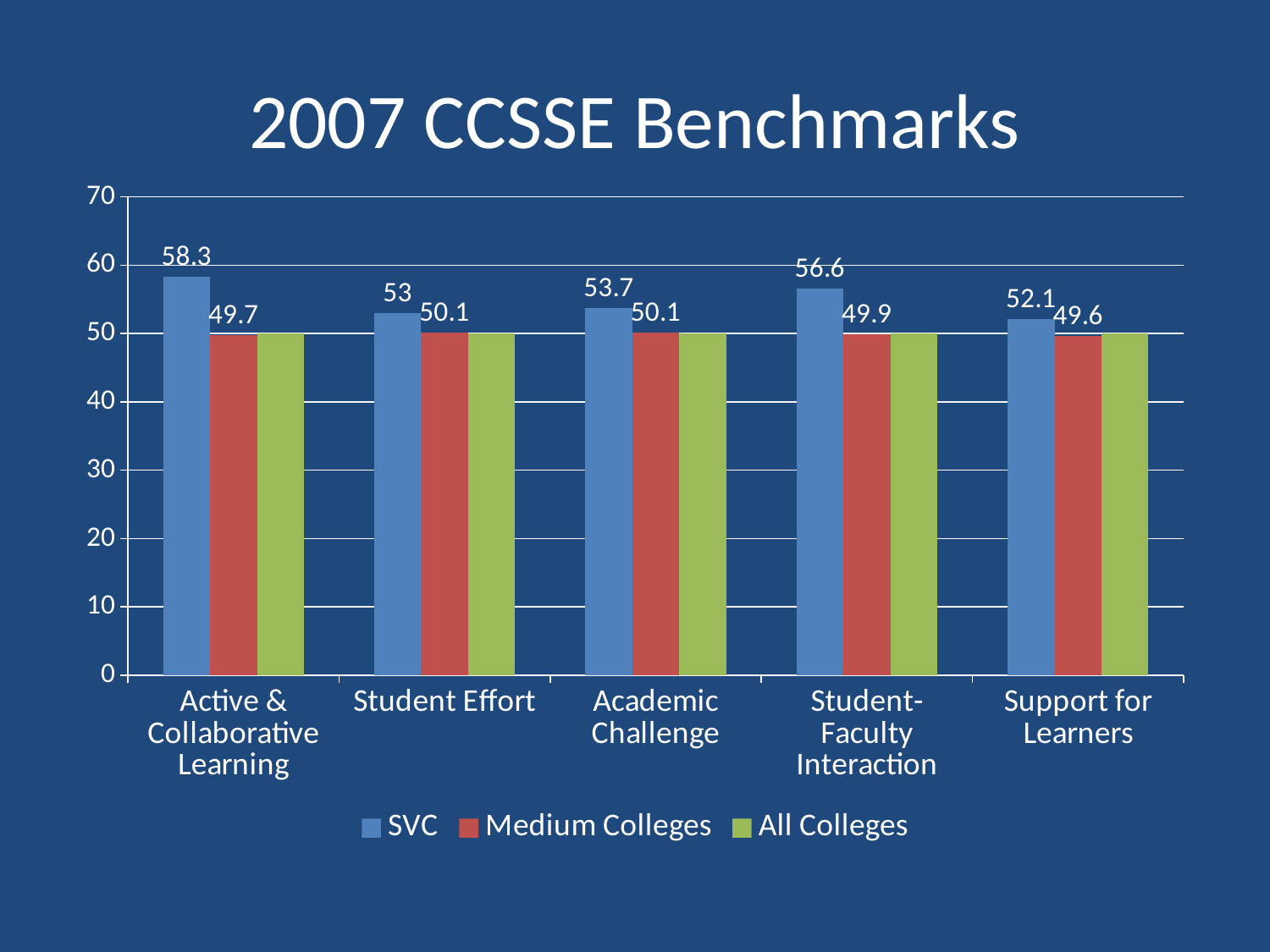
What is the SVC value for Active & Collaborative Learning? 58.3 What type of chart is shown on the slide? Bar chart What is the difference between the SVC and Medium Colleges values for Active & Collaborative Learning? 8.6 Is the All Colleges value for Student Effort greater or less than 40? greater Which benchmark has the lowest SVC value? Support for Learners How many benchmark categories are shown on the x axis? 5 How many series does the legend list? 3 What is the Medium Colleges value for Student-Faculty Interaction? 49.9 What is the SVC value for Support for Learners? 52.1 Which is larger, the SVC value for Academic Challenge or the SVC value for Student-Faculty Interaction? Student-Faculty Interaction Which benchmark has the highest SVC value? Active & Collaborative Learning What is the difference between the SVC values for Student-Faculty Interaction and Student Effort? 3.6